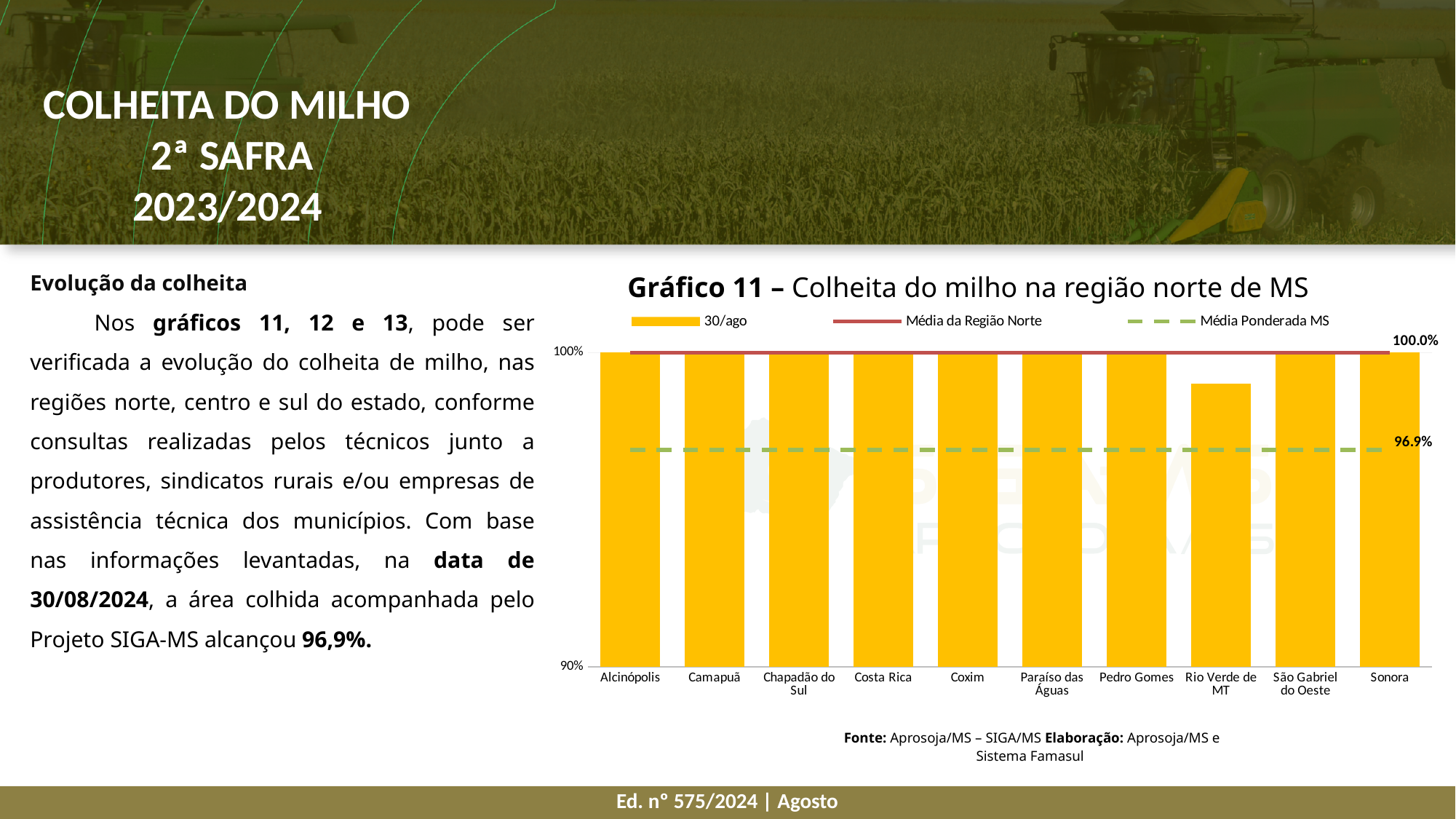
Which municipality has the lowest bar in Gráfico 11? Rio Verde de MT How many series does the legend of Gráfico 11 list? 3 What date does the legend of Gráfico 11 give for the bar series? 30/ago In Gráfico 11, which is larger, the bar for Sonora or the bar for Rio Verde de MT? Sonora In Gráfico 11, which is higher, the Média da Região Norte line or the Média Ponderada MS line? Média da Região Norte How many municipalities are shown on the x axis of Gráfico 11? 10 In Gráfico 11, is the value for Rio Verde de MT greater or less than 100%? less What value is labelled for the Média Ponderada MS line in Gráfico 11? 96.9% What kind of chart is Gráfico 11? combination bar and line chart What is the difference between the Média da Região Norte (100.0%) and the Média Ponderada MS (96.9%) in Gráfico 11? 3.1% What value is labelled for the Média da Região Norte line in Gráfico 11? 100.0% In Gráfico 11, is the value for Rio Verde de MT greater or less than 90%? greater